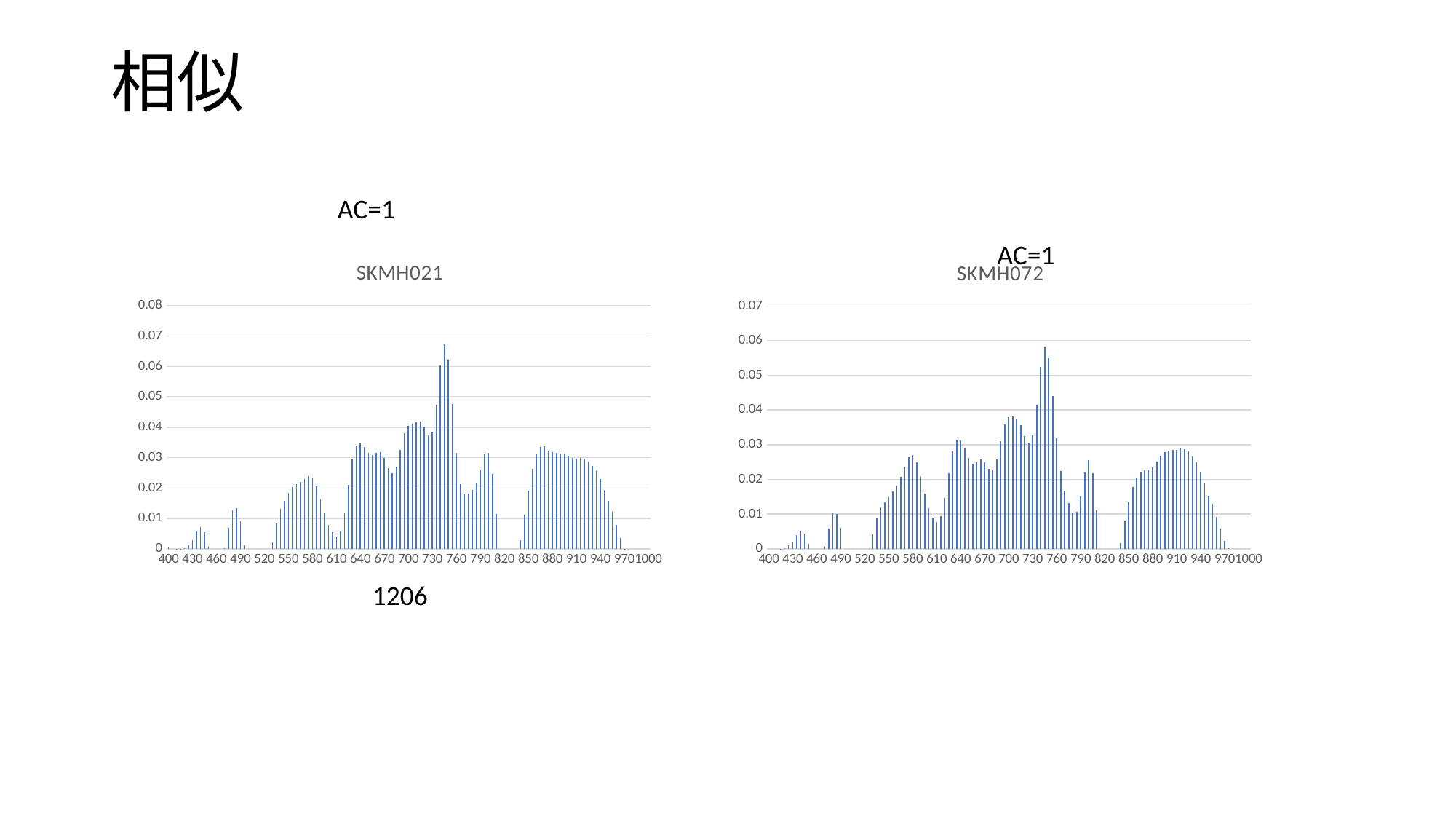
In the SKMH072 chart, is the tallest bar (near 745) greater or less than 0.06? less In the SKMH021 chart, is the tallest bar (near 750) greater or less than 0.06? greater What is the highest value labelled on the vertical axis of the SKMH021 chart? 0.08 In the SKMH021 chart, is the value at 400 greater or less than 0.01? less What is the title of the chart on the right? SKMH072 Which chart reaches a higher peak value, SKMH021 or SKMH072? SKMH021 What kind of chart is the SKMH021 chart on the left? bar chart How many tick labels are shown on the horizontal axis of the SKMH021 chart? 21